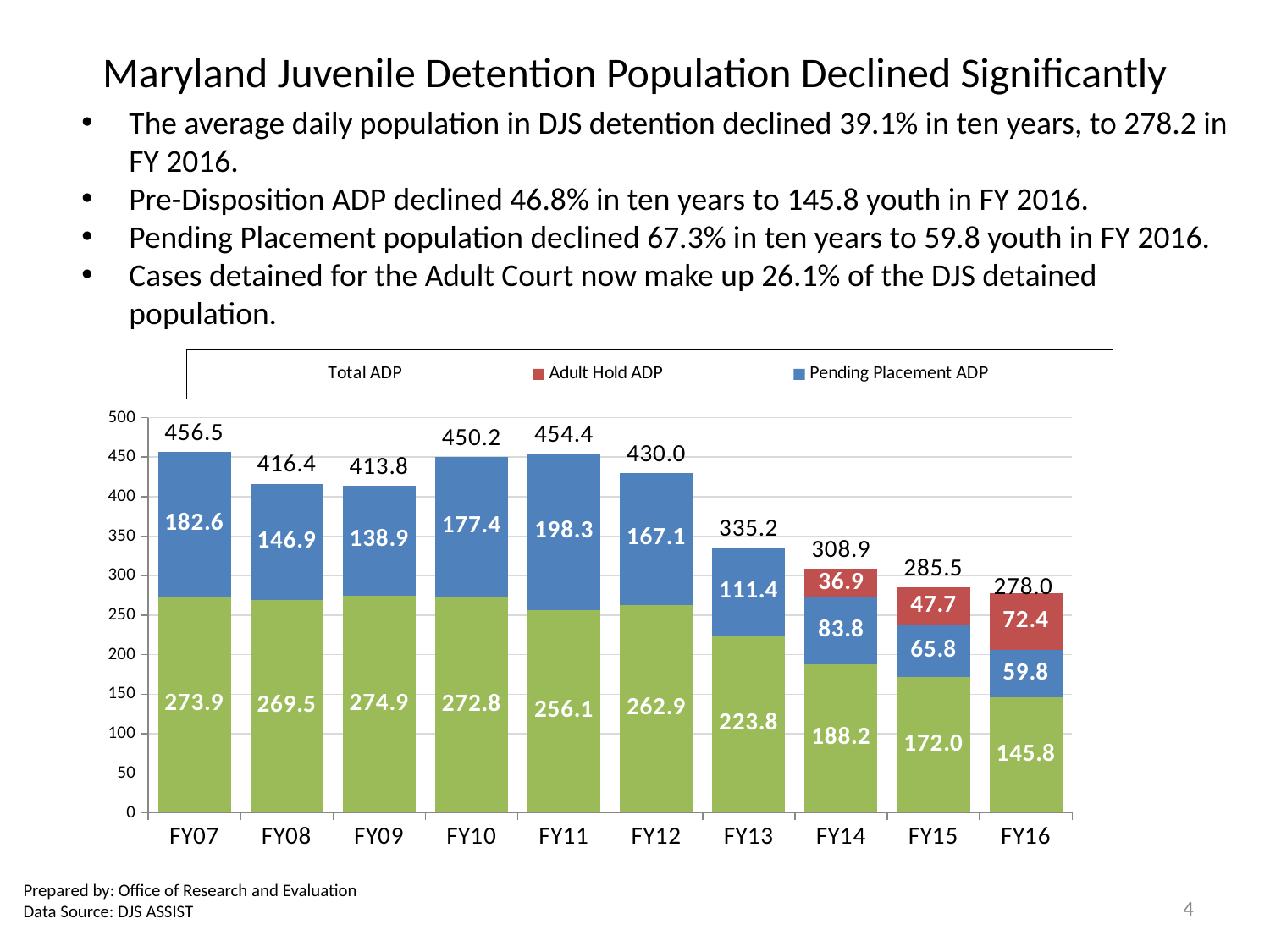
Which fiscal year has the lowest total ADP? FY16 Which is larger, the Pending Placement ADP in FY10 or in FY11? FY11 What total ADP is printed above the FY07 bar? 456.5 What is the value of the bottom (green) segment of the FY13 bar? 223.8 How many series does the legend list? 3 What is the Pending Placement ADP value for FY11? 198.3 Which fiscal year has the highest Pending Placement ADP? FY11 How many fiscal years are shown on the x axis? 10 Which fiscal year has the highest total ADP? FY07 What is the Adult Hold ADP value for FY16? 72.4 What is the difference between the Pending Placement ADP in FY07 and in FY16? 122.8 What kind of chart is shown on the slide? Stacked bar chart